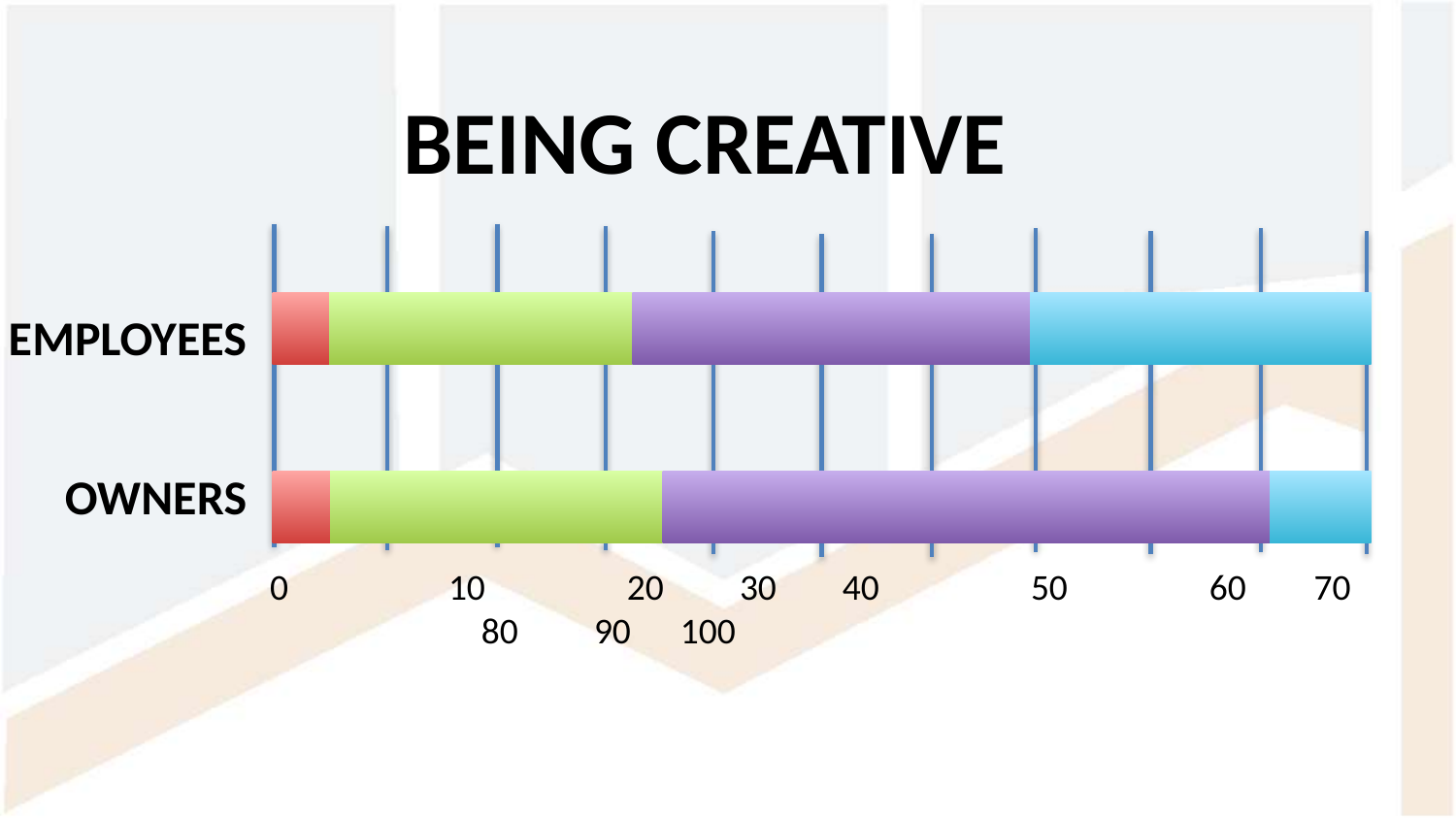
How many coloured segments make up each bar? 4 How many categories are plotted on the chart? 2 Which category has the longer purple segment, EMPLOYEES or OWNERS? OWNERS Which two categories are shown on the chart? EMPLOYEES and OWNERS Which category is listed at the top of the chart? EMPLOYEES Which category has the longer blue segment, EMPLOYEES or OWNERS? EMPLOYEES What is the highest value labelled on the axis? 100 What type of chart is shown on the slide? Stacked bar chart